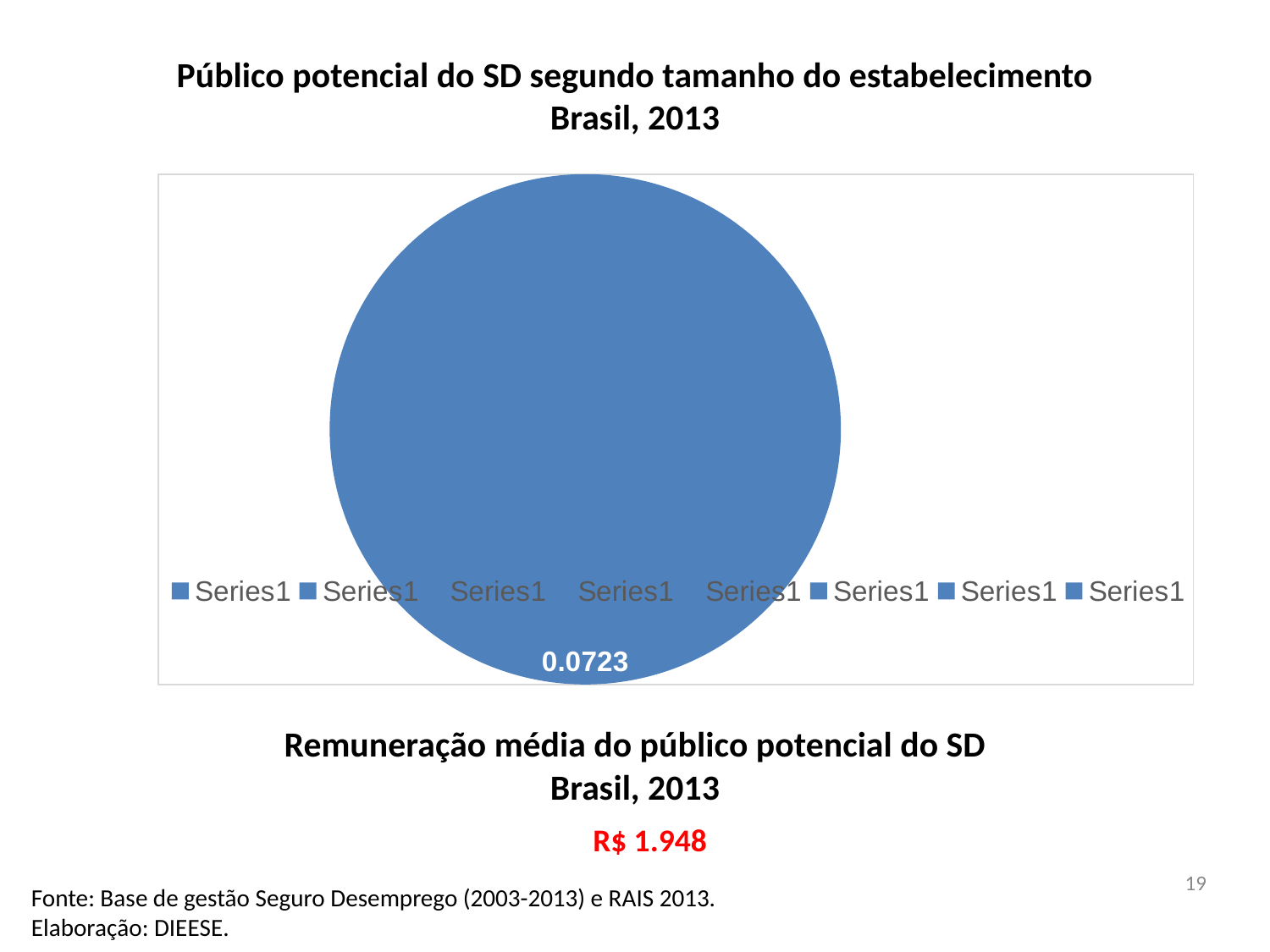
What colour is the pie chart? blue What data label is printed on the pie chart? 0.0723 What is the title of the chart on the slide? Público potencial do SD segundo tamanho do estabelecimento Brasil, 2013 How many entries does the chart's legend list? 8 What kind of chart is shown on the slide? pie chart